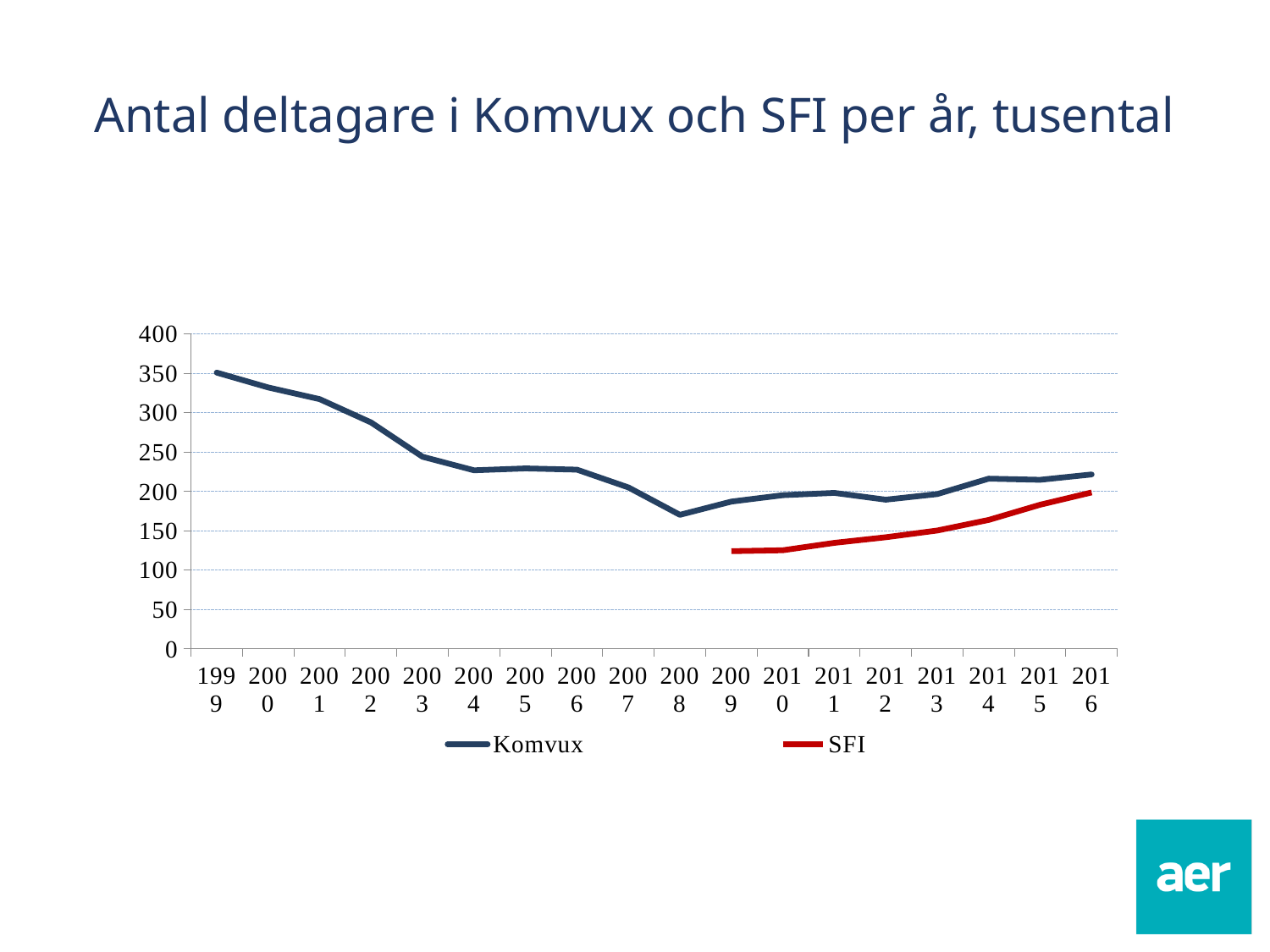
In which year does the SFI series reach its highest value? 2016 Is the value for SFI in 2009 greater or less than 150? less How many years are shown on the x axis? 18 Is the value for Komvux in 1999 greater or less than 300? greater How many series does the legend list? 2 Which series has the higher value in 2016, Komvux or SFI? Komvux In which year does the Komvux series reach its lowest value? 2008 Does the SFI series rise or fall from 2009 to 2016? rise What kind of chart is shown on the slide? line chart In which year does the Komvux series reach its highest value? 1999 What is the title of the chart? Antal deltagare i Komvux och SFI per år, tusental Is the value for Komvux in 2008 greater or less than 200? less